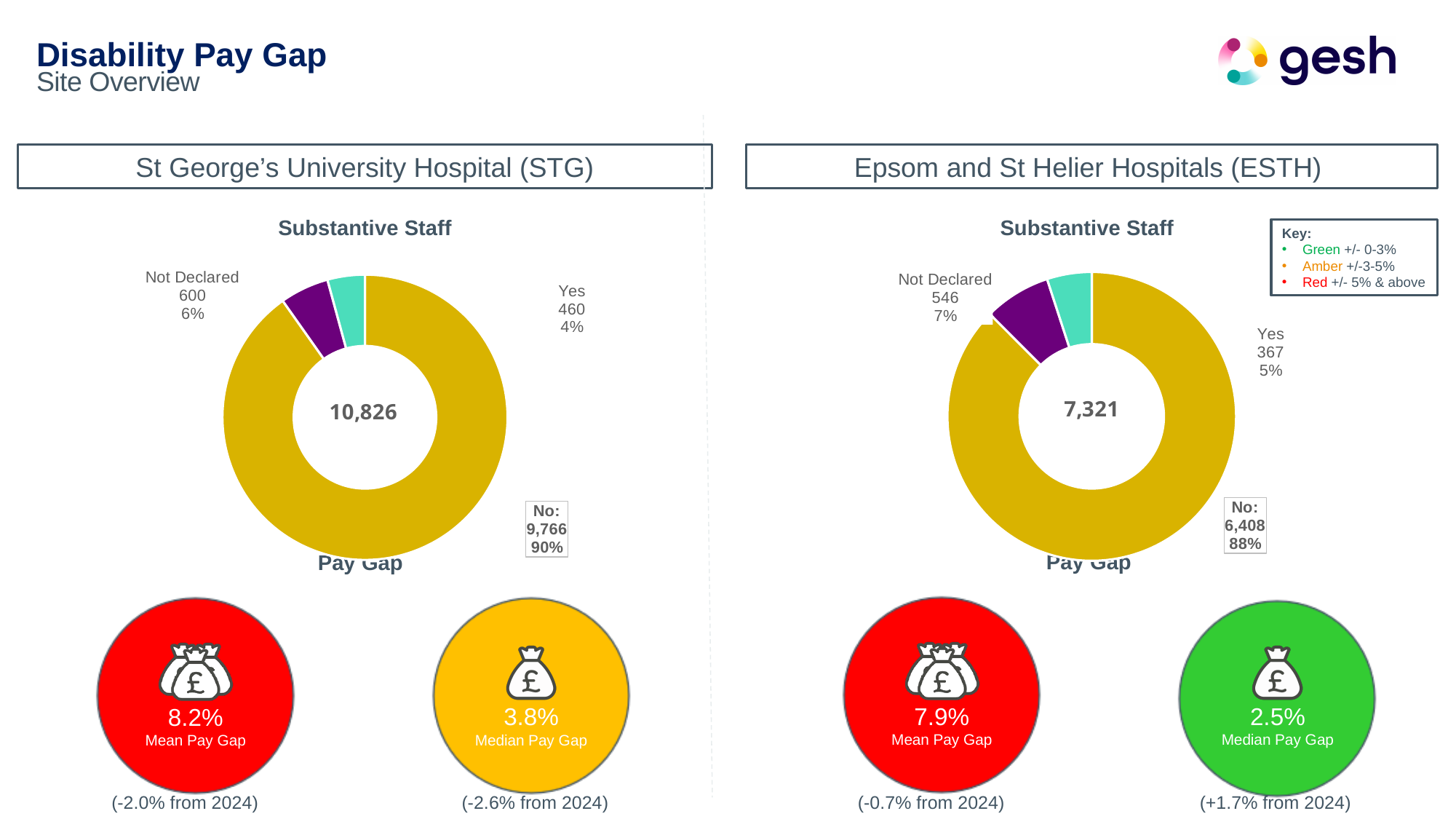
On the St George's University Hospital (STG) Substantive Staff chart, how many staff are in the 'No' category? 9,766 On the St George's University Hospital (STG) Substantive Staff chart, what is the difference between the 'Not Declared' count and the 'Yes' count? 140 On the Epsom and St Helier Hospitals (ESTH) Substantive Staff chart, what share of staff are in the 'No' category? 88% What is the total number of substantive staff shown in the centre of the St George's University Hospital (STG) chart? 10,826 What is the total number of substantive staff shown in the centre of the Epsom and St Helier Hospitals (ESTH) chart? 7,321 What type of chart is used for Substantive Staff on the Epsom and St Helier Hospitals (ESTH) side of the slide? Donut (pie) chart How many categories does the St George's University Hospital (STG) Substantive Staff chart show? 3 On the St George's University Hospital (STG) Substantive Staff chart, what percentage of staff are 'Not Declared'? 6% On the Epsom and St Helier Hospitals (ESTH) Substantive Staff chart, which is larger: the 'Not Declared' count or the 'Yes' count? Not Declared On the Epsom and St Helier Hospitals (ESTH) Substantive Staff chart, which category has the largest number of staff? No On the St George's University Hospital (STG) Substantive Staff chart, which category has the smallest number of staff? Yes On the Epsom and St Helier Hospitals (ESTH) Substantive Staff chart, how many staff answered 'Yes'? 367